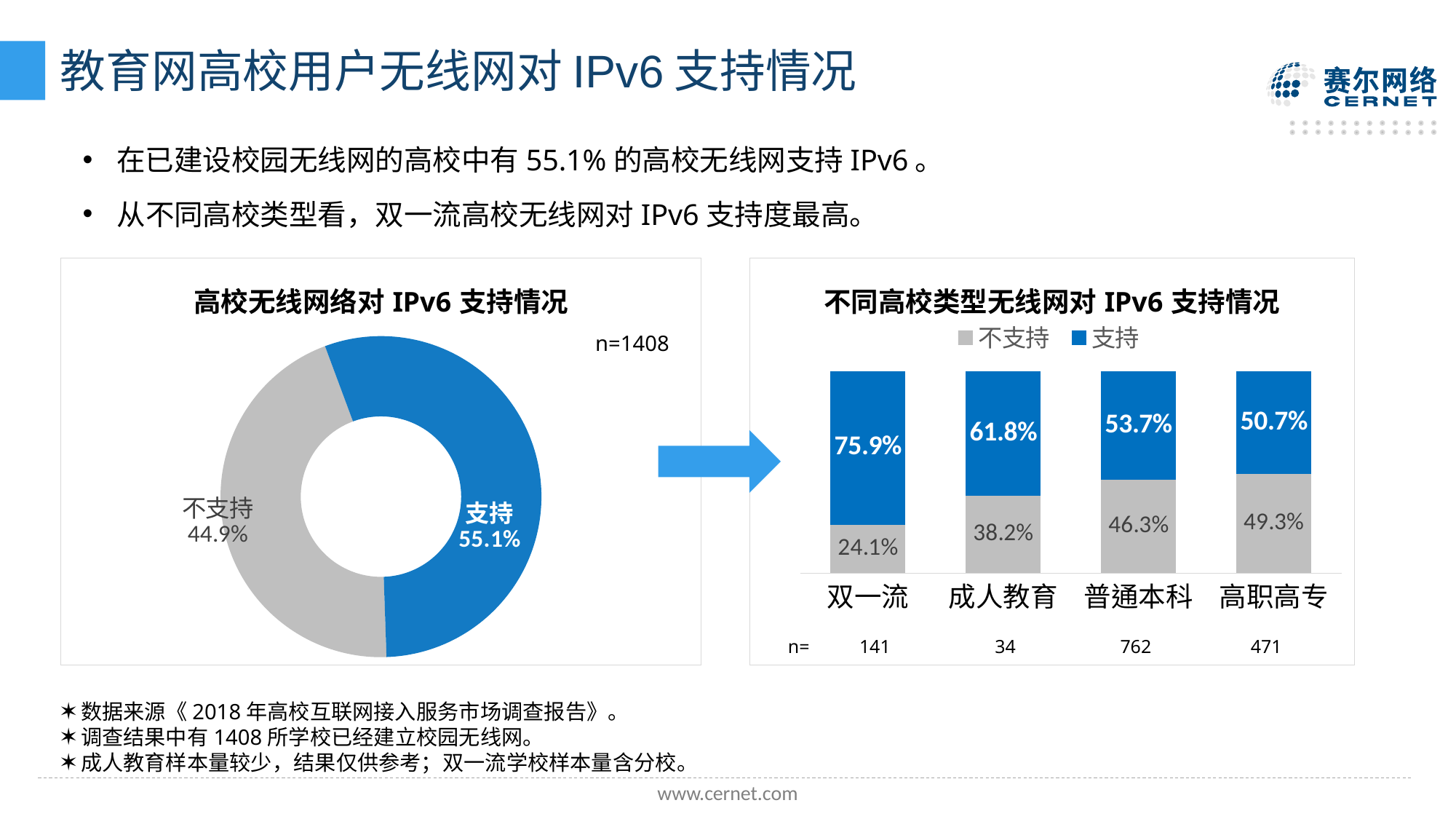
In the chart titled 不同高校类型无线网对 IPv6 支持情况, which category has the highest 支持 value? 双一流 In the chart titled 不同高校类型无线网对 IPv6 支持情况, what is the 不支持 value for 普通本科? 46.3% In the chart titled 高校无线网络对 IPv6 支持情况, what share of the pie is 支持? 55.1% What kind of chart is the one on the left titled 高校无线网络对 IPv6 支持情况? Pie (donut) chart In the chart titled 不同高校类型无线网对 IPv6 支持情况, what is the difference between the 支持 values for 双一流 and 成人教育? 14.1% In the chart titled 不同高校类型无线网对 IPv6 支持情况, what is the 支持 value for 双一流? 75.9% In the chart titled 高校无线网络对 IPv6 支持情况, what sample size (n) is shown? n=1408 In the chart titled 高校无线网络对 IPv6 支持情况, what is the value for 不支持? 44.9% In the chart titled 不同高校类型无线网对 IPv6 支持情况, which is larger: the 不支持 value for 成人教育 or for 高职高专? 高职高专 In the chart titled 不同高校类型无线网对 IPv6 支持情况, how many categories are shown on the x axis? 4 In the chart titled 不同高校类型无线网对 IPv6 支持情况, how many series does the legend list? 2 In the chart titled 不同高校类型无线网对 IPv6 支持情况, which category has the lowest 支持 value? 高职高专